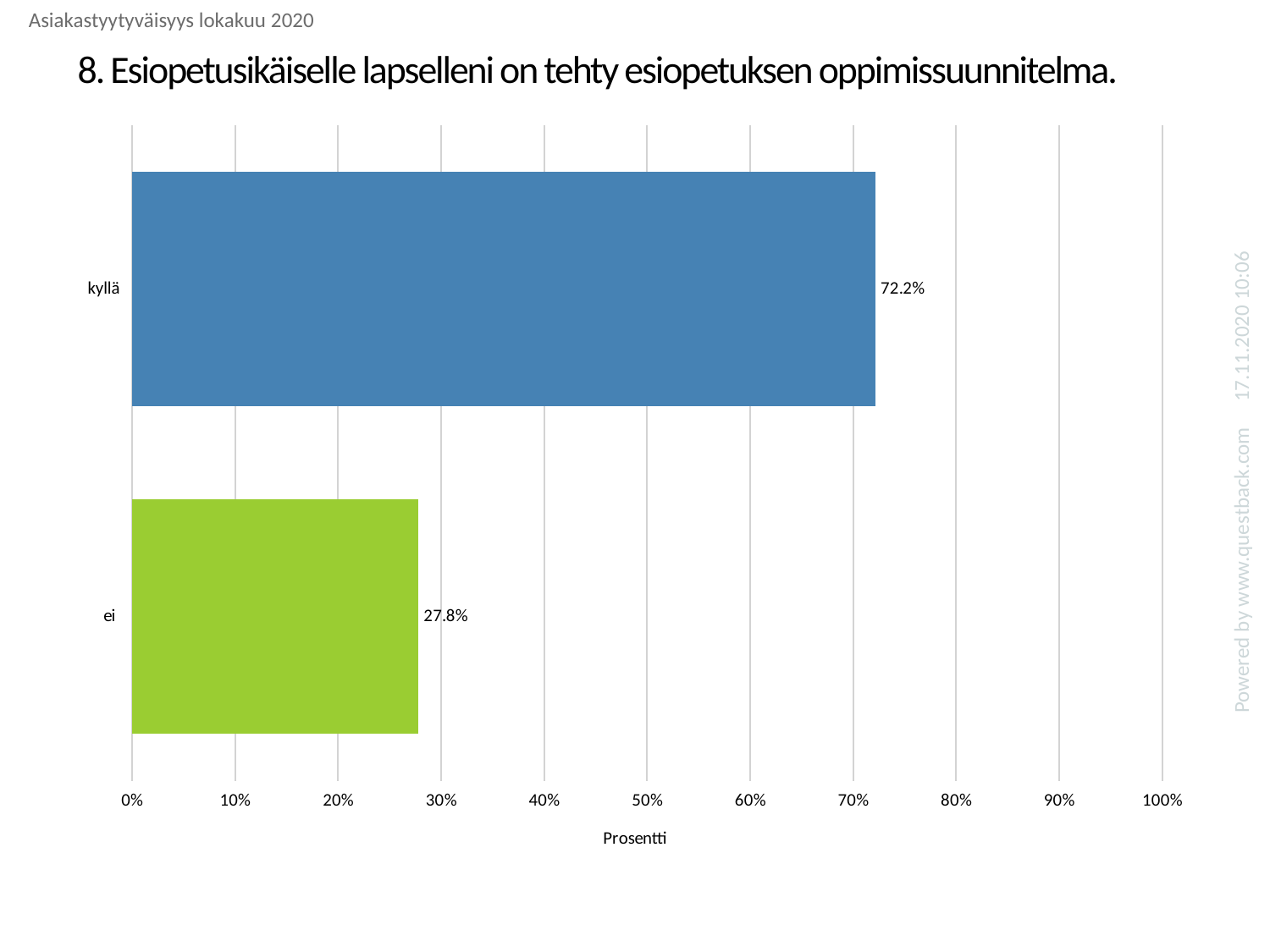
What is the difference between the values for "kyllä" and "ei"? 44.4% How many categories are shown in the chart? 2 Is the value for "ei" greater or less than 30%? less Which category has the lowest value? ei What is the total of the two bar values? 100% What is the value for "kyllä"? 72.2% Which is larger, the value for "kyllä" or the value for "ei"? kyllä What kind of chart is shown on the slide? bar chart What is the value for "ei"? 27.8% Is the value for "kyllä" greater or less than 70%? greater What is the label of the horizontal axis? Prosentti Which category has the highest value? kyllä